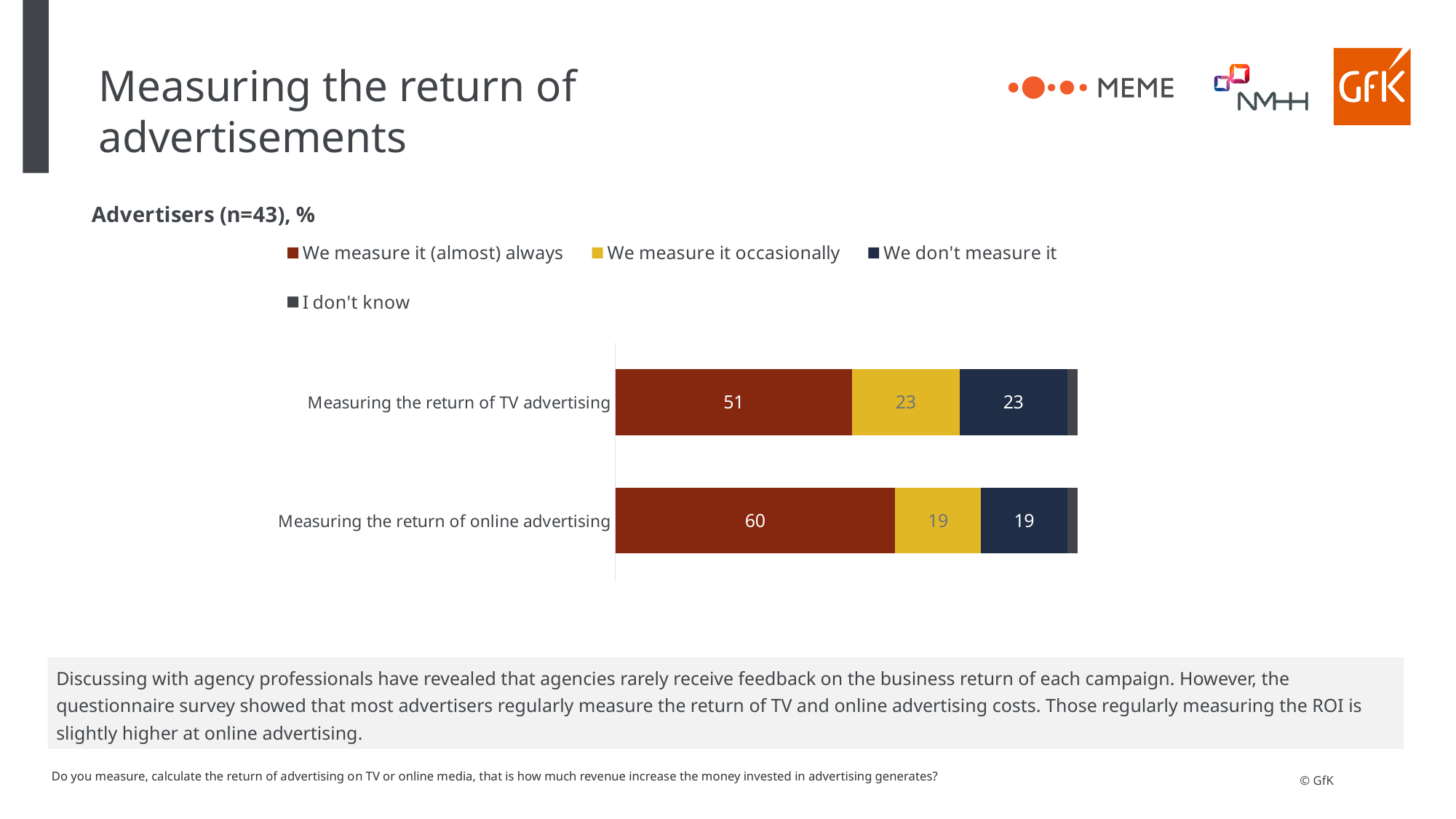
What percentage of advertisers say they measure the return of TV advertising (almost) always? 51 What is the value for 'We measure it occasionally' for measuring the return of TV advertising? 23 What percentage of advertisers say they measure the return of online advertising (almost) always? 60 Which category has the higher value for 'We measure it occasionally'? Measuring the return of TV advertising What type of chart is shown on the slide? Stacked bar chart How many series does the legend list? 4 Which legend entry is shown in dark red? We measure it (almost) always What is the value for 'We don't measure it' for measuring the return of online advertising? 19 How many categories (bars) are shown in the chart? 2 Which category has the higher value for 'We measure it (almost) always': TV advertising or online advertising? Measuring the return of online advertising What is the title of the chart? Advertisers (n=43), % What is the difference between the 'We measure it (almost) always' values for online advertising and TV advertising? 9